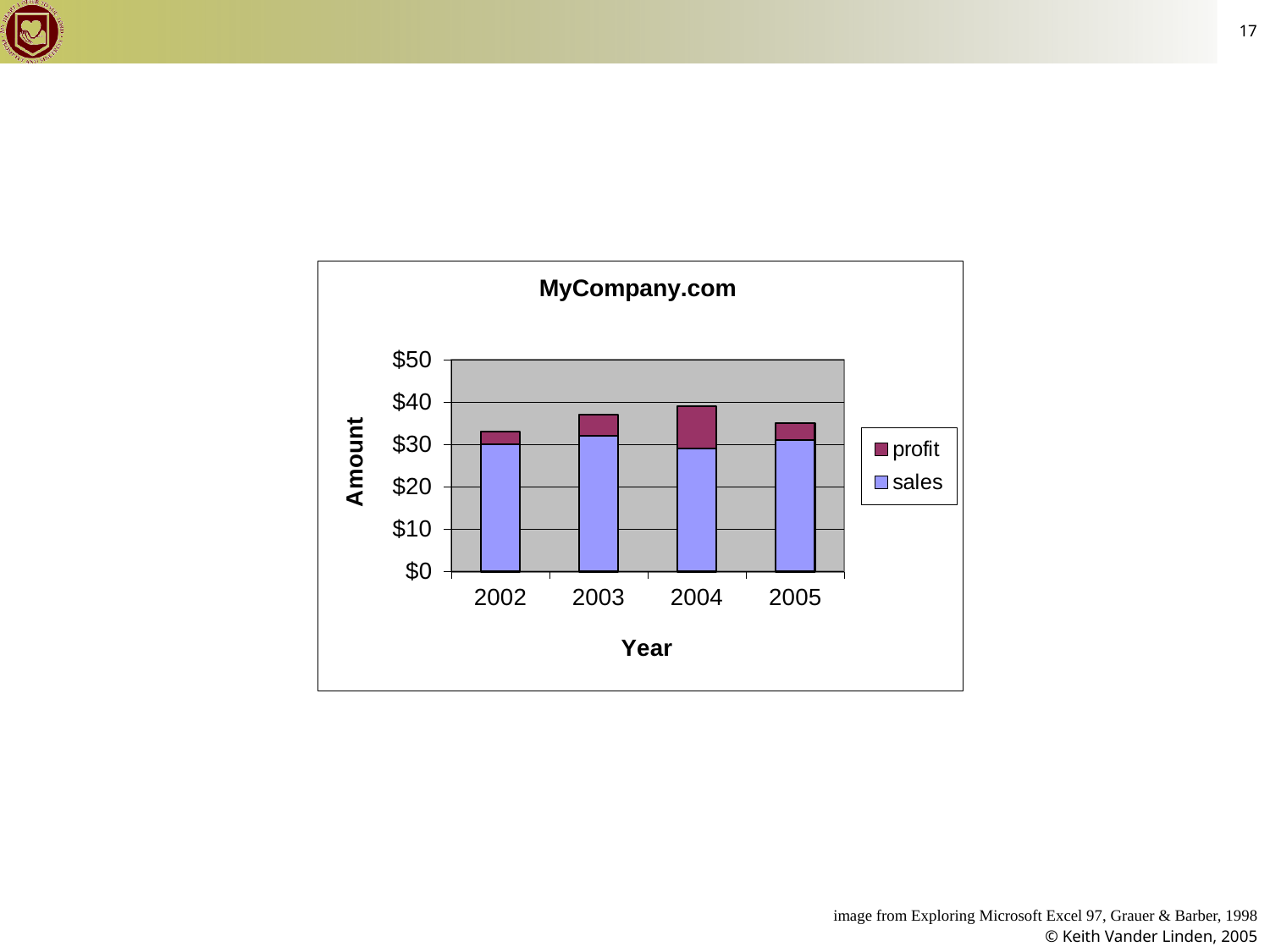
How many years are shown on the x axis? 4 What kind of chart is shown on the slide? bar chart Is the total height of the stacked bar for 2002 greater or less than $40? less Which year has a taller stacked bar, 2002 or 2004? 2004 What is the title of the chart? MyCompany.com Does the total height of the stacked bars rise or fall from 2002 to 2004? rise Which year has the tallest stacked bar (highest total of sales and profit)? 2004 How many series does the legend list? 2 Is the sales value for 2005 greater or less than $20? greater Which year has the shortest stacked bar (lowest total of sales and profit)? 2002 Which series are listed in the legend? profit, sales Is the total height of the stacked bar for 2004 greater or less than $30? greater